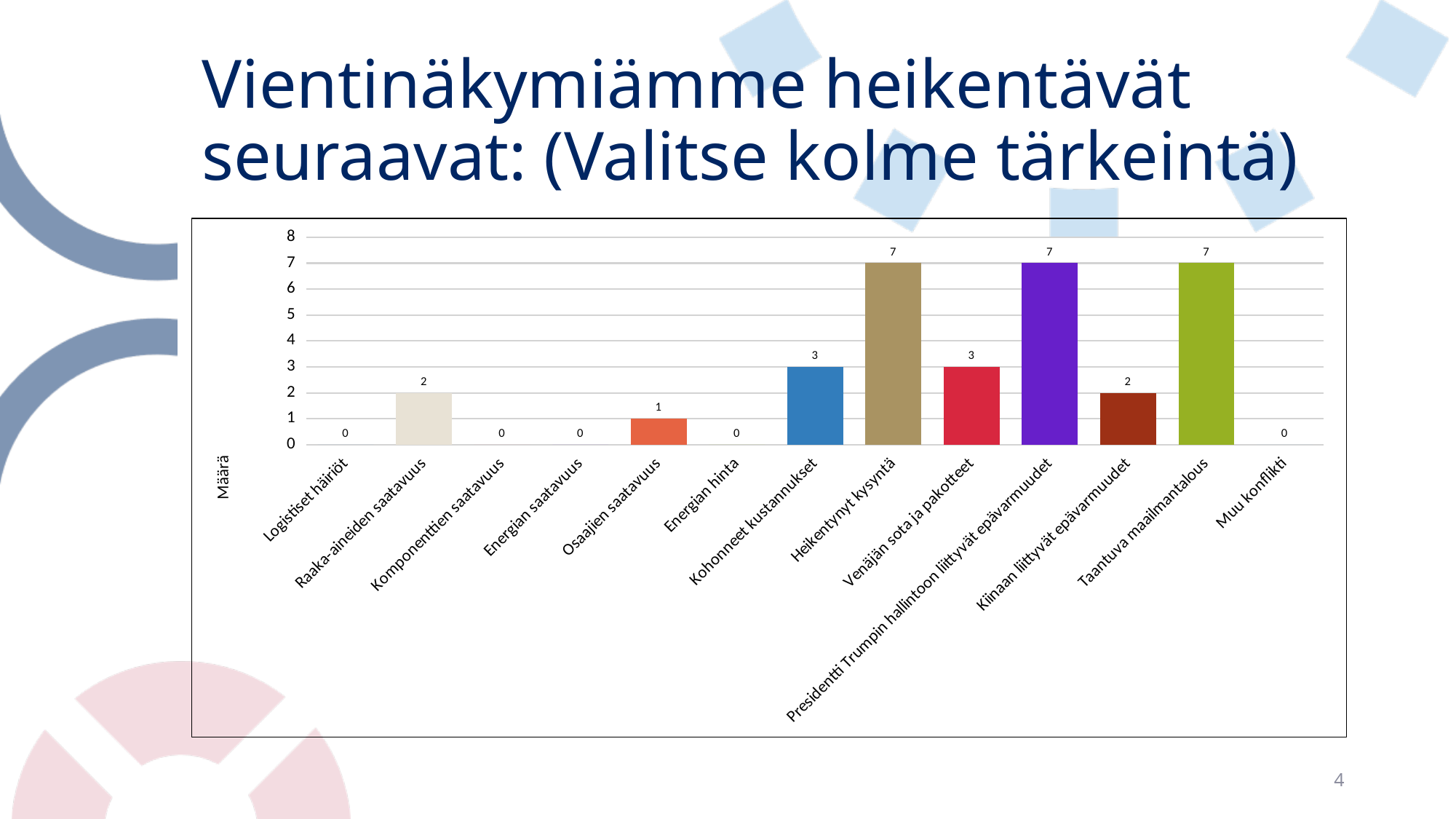
What is the value for Osaajien saatavuus? 1 What kind of chart is shown on the slide? Bar chart How many categories are shown on the x axis of the chart? 13 What is the value for Raaka-aineiden saatavuus? 2 What is the value for Kiinaan liittyvät epävarmuudet? 2 What is the value for Muu konflikti? 0 What is the value for Heikentynyt kysyntä? 7 Which is larger, the value for Kohonneet kustannukset or the value for Osaajien saatavuus? Kohonneet kustannukset What is the difference between the values for Taantuva maailmantalous and Venäjän sota ja pakotteet? 4 What is the label on the vertical axis of the chart? Määrä Which is larger, the value for Presidentti Trumpin hallintoon liittyvät epävarmuudet or the value for Kiinaan liittyvät epävarmuudet? Presidentti Trumpin hallintoon liittyvät epävarmuudet What is the value for Kohonneet kustannukset? 3